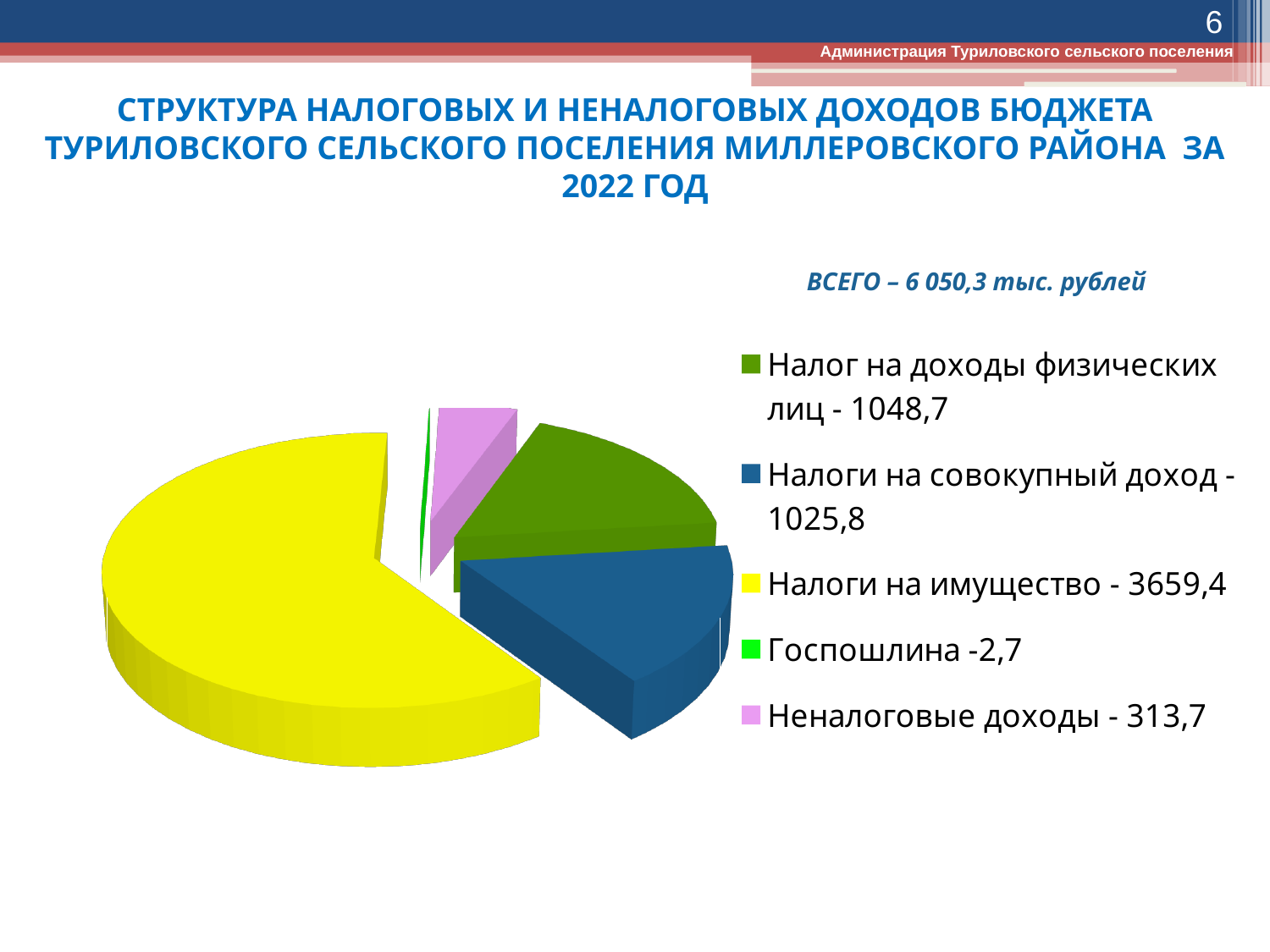
What kind of chart is shown on the slide? Pie chart What is the difference between Налог на доходы физических лиц and Налоги на совокупный доход? 22,9 What is the value for Неналоговые доходы? 313,7 What colour is the slice for Налоги на имущество? Yellow What total amount is stated above the chart (ВСЕГО)? 6 050,3 тыс. рублей Which category has the largest value? Налоги на имущество What is the value for Госпошлина? 2,7 Which is larger: Налог на доходы физических лиц or Налоги на совокупный доход? Налог на доходы физических лиц How many categories does the pie chart show? 5 What is the value for Налог на доходы физических лиц? 1048,7 What is the value for Налоги на имущество? 3659,4 Which category has the smallest value? Госпошлина